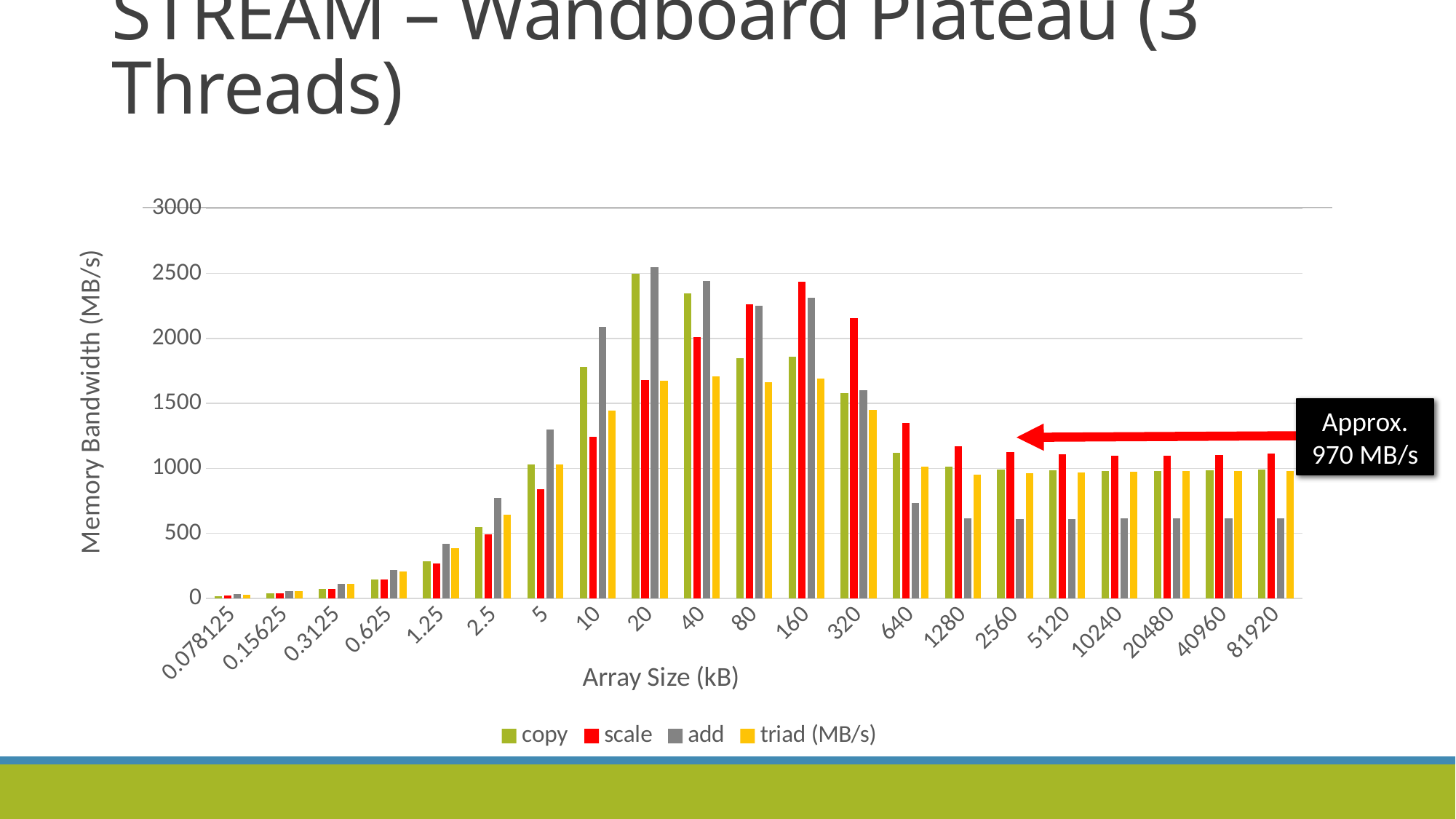
What kind of chart is shown on the slide? bar chart Is the value for scale at array size 160 greater or less than 2000? greater Is the value for add at array size 20 greater or less than 2500? greater How many array size categories are shown on the x axis? 21 Is the value for add at array size 640 greater or less than 1000? less At array size 80, which is larger: add or triad? add Which series has the lowest value at array size 2560? add Does the copy series rise or fall from array size 20 to array size 640? fall How many series does the legend list? 4 What is the label on the y axis? Memory Bandwidth (MB/s) Which series has the highest value at array size 320? scale